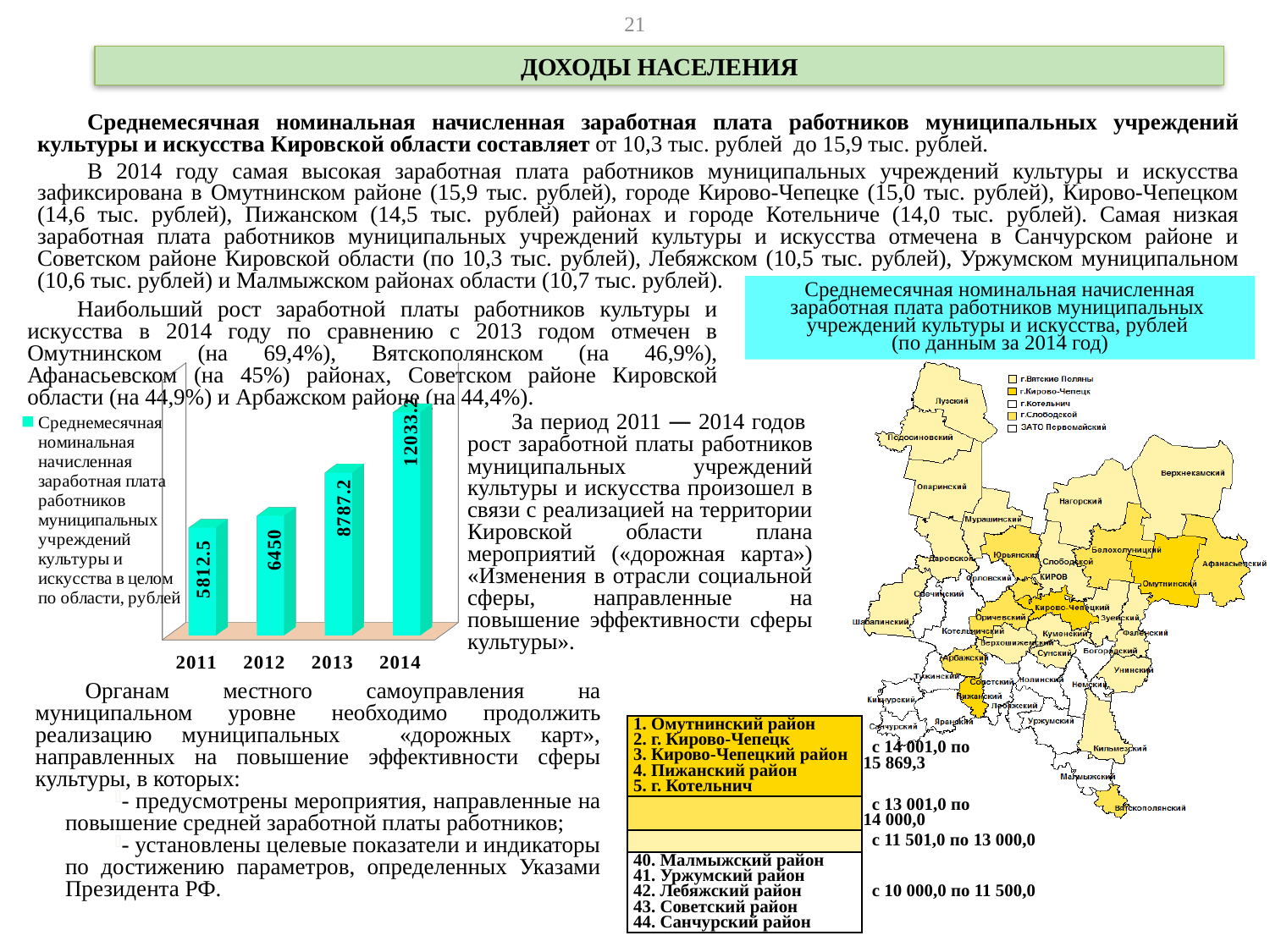
Which is larger in the bar chart, the value for 2012 or the value for 2013? 2013 What is the difference between the values for 2012 and 2011 in the bar chart? 637.5 How many years are shown on the x axis of the bar chart? 4 What is the value for 2012 in the bar chart? 6450 Which year has the highest value in the bar chart? 2014 Which year has the lowest value in the bar chart? 2011 What is the difference between the values for 2013 and 2012 in the bar chart? 2337.2 What is the value for 2011 in the bar chart? 5812.5 What is the value for 2013 in the bar chart? 8787.2 How many series does the legend of the bar chart list? 1 Do the values in the bar chart rise or fall from 2011 to 2014? rise What kind of chart is used to show the average monthly wage by year? bar chart